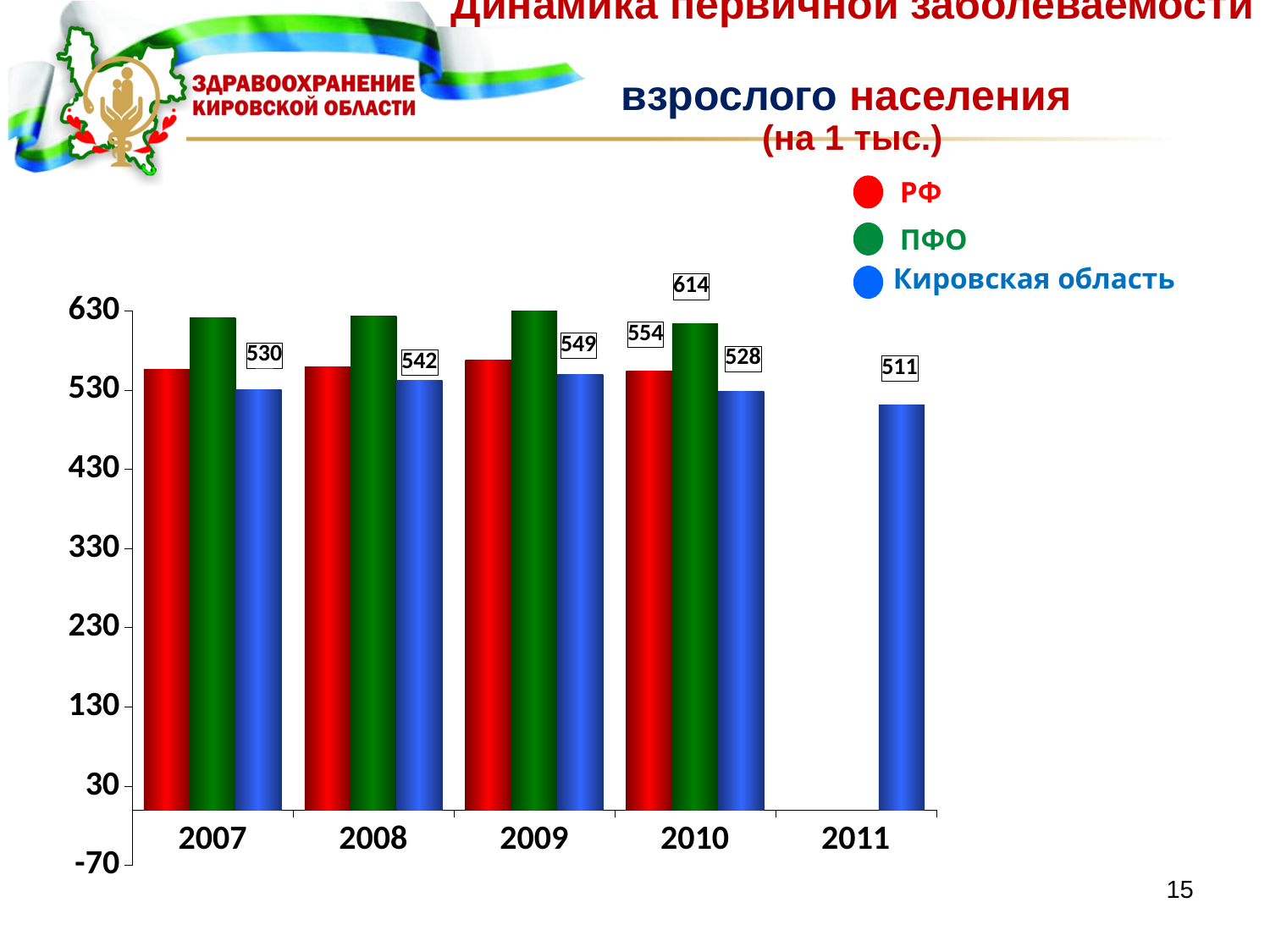
Is the value for РФ in 2007 greater or less than 530? greater What kind of chart is shown on the slide? bar chart In which year is the value for Кировская область highest? 2009 What is the value for Кировская область in 2011? 511 In 2010, which is larger: the value for ПФО or for РФ? ПФО What is the difference between the Кировская область values in 2008 and 2011? 31 How many series does the legend list? 3 What is the value for Кировская область in 2007? 530 What is the value for РФ in 2010? 554 What is the difference between the ПФО and РФ values in 2010? 60 In which year is the value for Кировская область lowest? 2011 What is the value for ПФО in 2010? 614